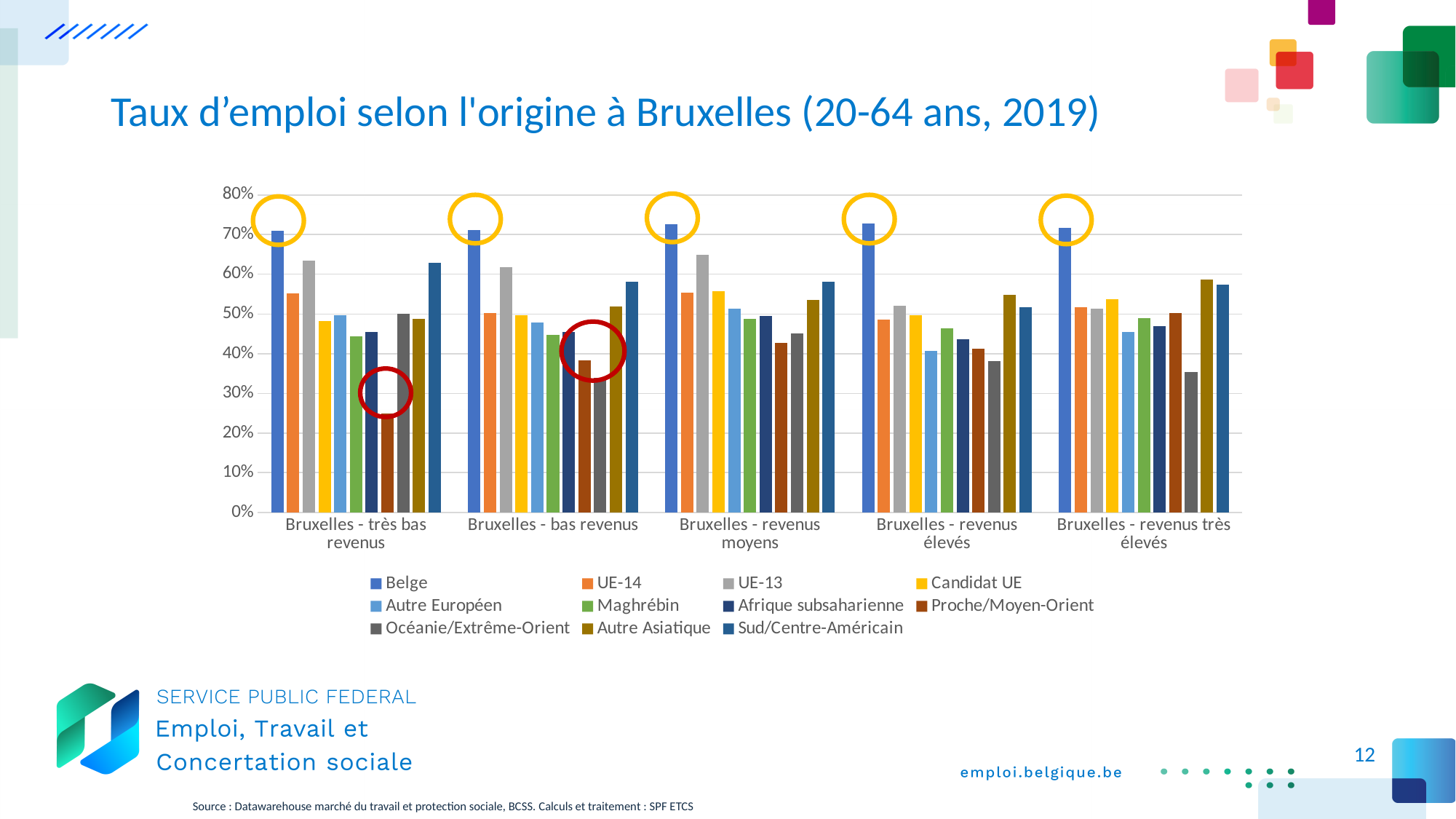
Which origin has the lowest employment rate in the 'Bruxelles - bas revenus' category? Océanie/Extrême-Orient In the 'Bruxelles - revenus élevés' category, which is larger: Autre Asiatique or Sud/Centre-Américain? Autre Asiatique How many income categories are shown along the x axis? 5 Which origin has the lowest employment rate in the 'Bruxelles - très bas revenus' category? Proche/Moyen-Orient How many series does the legend list? 11 Which origin has the highest employment rate in the 'Bruxelles - très bas revenus' category? Belge Is the value for Belge in 'Bruxelles - revenus moyens' greater or less than 70%? greater Is the value for Proche/Moyen-Orient in 'Bruxelles - très bas revenus' greater or less than 40%? less Which origin has the lowest employment rate in the 'Bruxelles - revenus très élevés' category? Océanie/Extrême-Orient What kind of chart is shown on the slide? bar chart What is the title of the chart on the slide? Taux d'emploi selon l'origine à Bruxelles (20-64 ans, 2019) In the 'Bruxelles - très bas revenus' category, which is larger: UE-13 or UE-14? UE-13